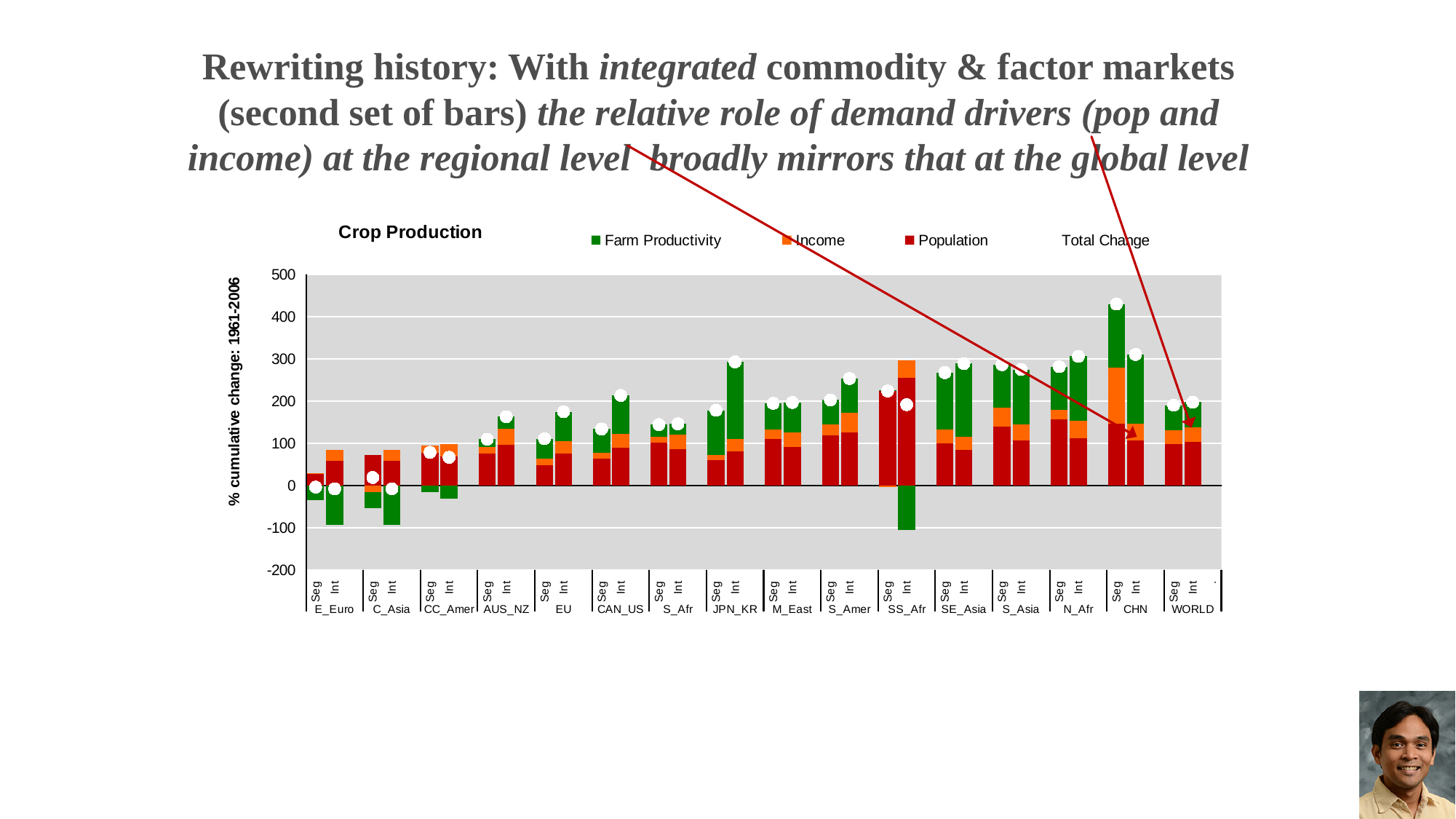
How many regions are shown along the x axis of the chart? 16 What is the title of the chart? Crop Production What is the label of the vertical axis of the chart? % cumulative change: 1961-2006 Which bar has the highest Total Change in the chart? CHN Seg Which has the larger Total Change, the JPN_KR Seg bar or the JPN_KR Int bar? JPN_KR Int What kind of chart is shown on the slide? Stacked bar chart Is the Total Change for the E_Euro Seg bar greater or less than 100? less Is the Total Change for the JPN_KR Int bar greater or less than 200? greater Is the Total Change for the AUS_NZ Int bar greater or less than 200? less How many entries does the chart legend list? 4 Which has the larger Total Change, the CHN Seg bar or the CHN Int bar? CHN Seg